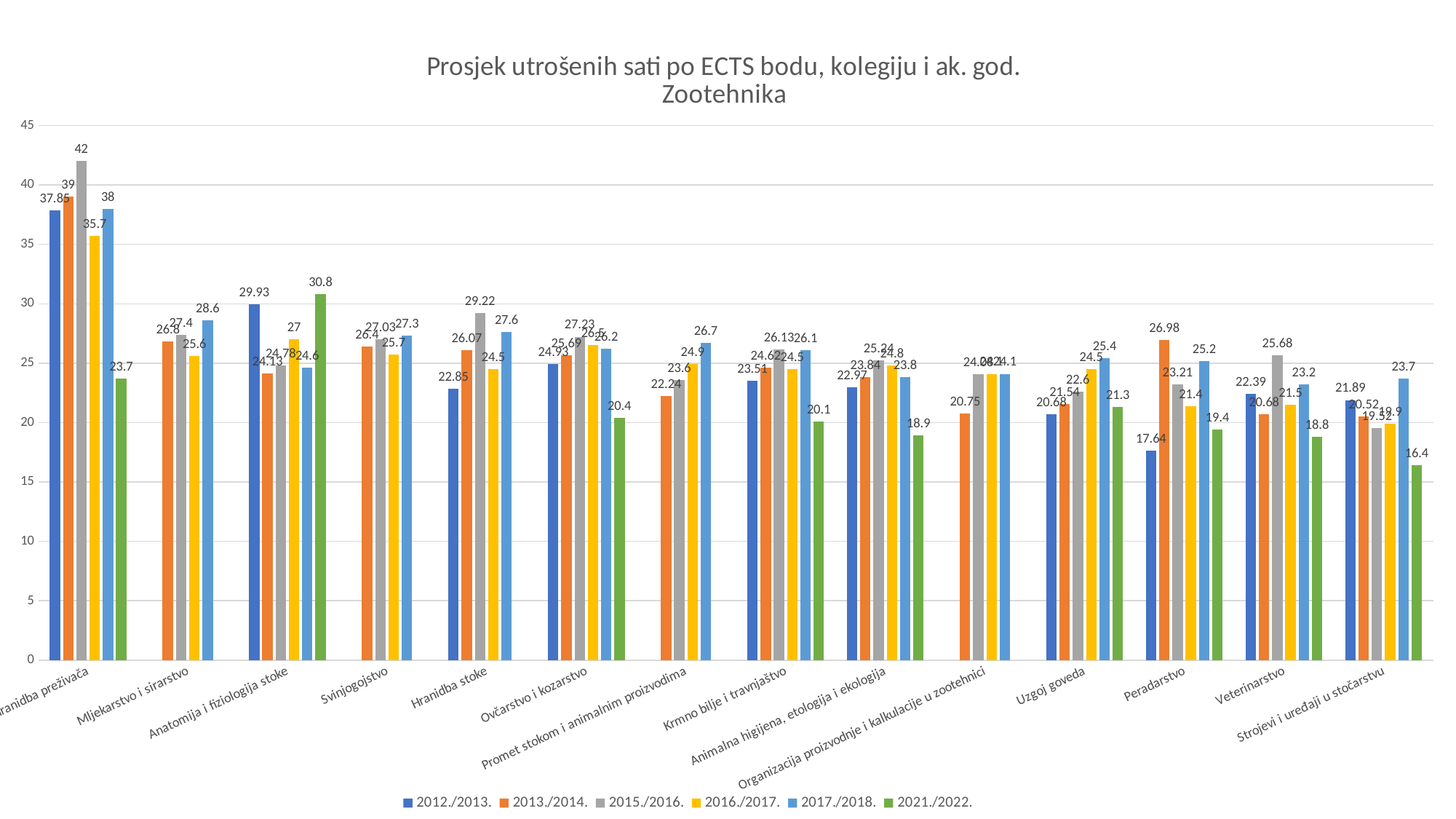
How many series does the legend list? 6 Which is larger for Veterinarstvo: the 2012./2013. value or the 2015./2016. value? 2015./2016. What is the value for Hranidba stoke in the 2015./2016. series? 29.22 Is the value for Uzgoj goveda in the 2017./2018. series greater or less than 25? greater Which category has the lowest value in the 2021./2022. series? Strojevi i uređaji u stočarstvu How many categories are shown on the x axis? 14 What kind of chart is shown on the slide? bar chart Which category has the highest value in the 2015./2016. series? Hranidba preživača What is the difference between the 2015./2016. and 2016./2017. values for Hranidba preživača? 6.3 What is the value for Peradarstvo in the 2013./2014. series? 26.98 What is the value for Anatomija i fiziologija stoke in the 2021./2022. series? 30.8 What is the title of the chart? Prosjek utrošenih sati po ECTS bodu, kolegiju i ak. god. Zootehnika